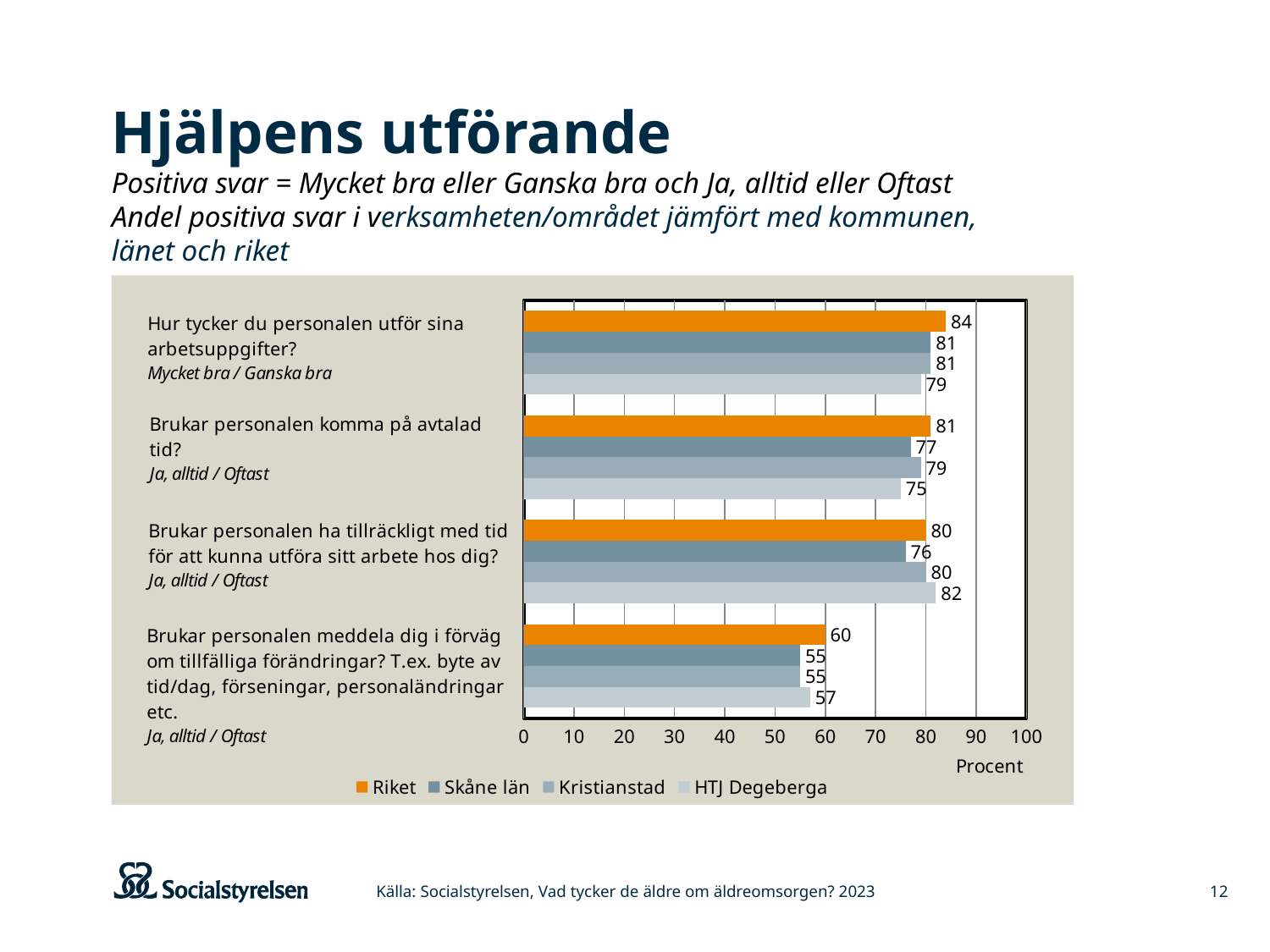
What is the value for Riket on "Hur tycker du personalen utför sina arbetsuppgifter?"? 84 How many question categories are plotted in the chart? 4 Which series has the highest value on "Brukar personalen ha tillräckligt med tid för att kunna utföra sitt arbete hos dig?"? HTJ Degeberga Which is larger on "Brukar personalen meddela dig i förväg om tillfälliga förändringar?": Riket or HTJ Degeberga? Riket What is the value for Kristianstad on "Brukar personalen meddela dig i förväg om tillfälliga förändringar?"? 55 What is the label of the x axis? Procent Which question has the lowest value for Riket? Brukar personalen meddela dig i förväg om tillfälliga förändringar? How many series does the legend list? 4 What is the difference between Riket and HTJ Degeberga on "Brukar personalen komma på avtalad tid?"? 6 What is the value for Skåne län on "Brukar personalen ha tillräckligt med tid för att kunna utföra sitt arbete hos dig?"? 76 What is the value for HTJ Degeberga on "Brukar personalen komma på avtalad tid?"? 75 What type of chart is shown on the slide? bar chart